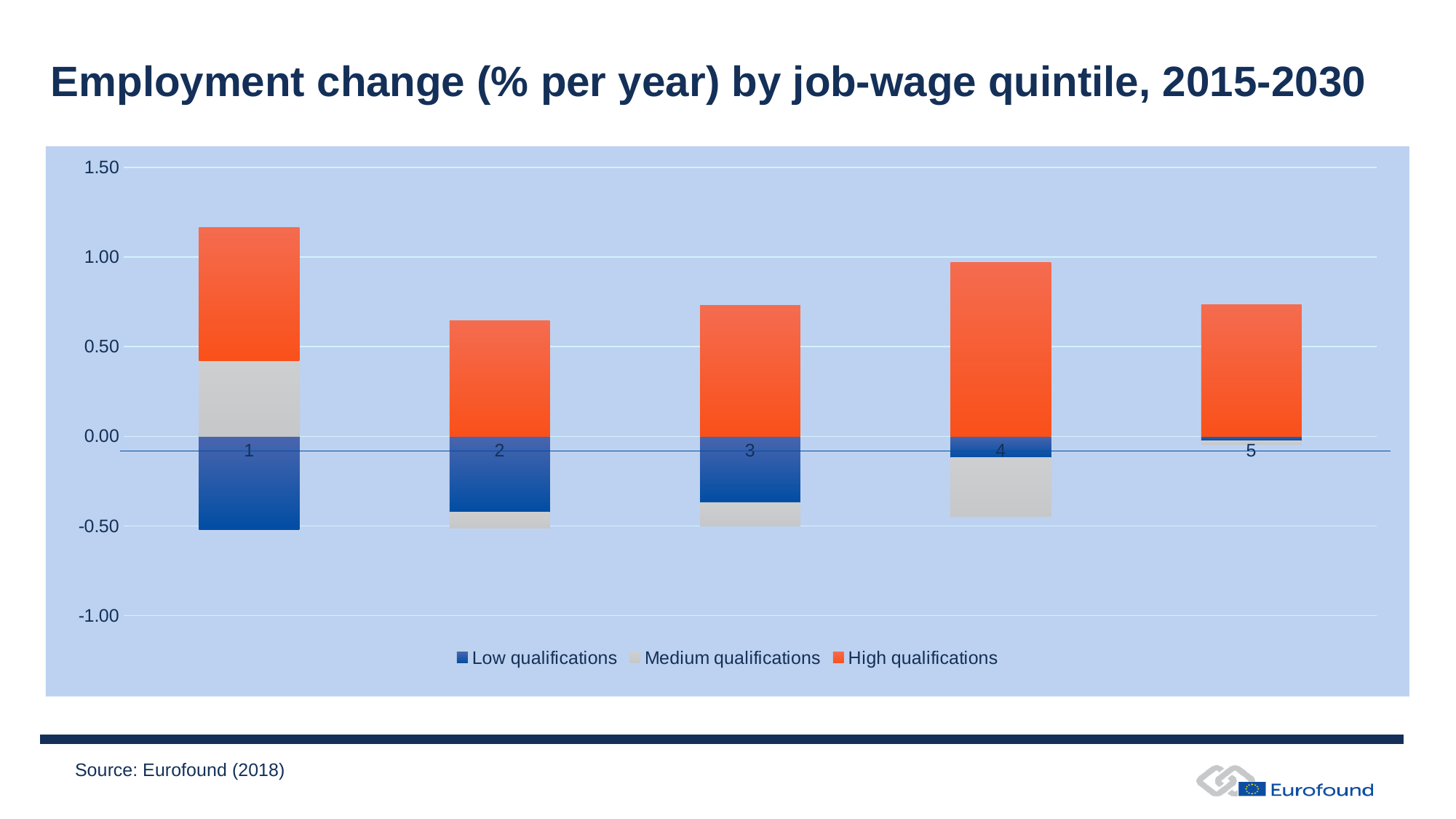
Which series is shown in orange in the legend? High qualifications Which quintile is the only one with a positive Medium qualifications value? 1 Which quintile has a larger High qualifications value, quintile 1 or quintile 4? 4 Which quintile has the smallest negative Low qualifications value (closest to zero)? 5 How many series does the legend list? 3 Is the High qualifications value for quintile 2 greater or less than 0.50? greater Is the Low qualifications value for quintile 3 greater or less than -0.50? greater Which quintile has the largest positive value for High qualifications? 4 What kind of chart is shown on the slide? Stacked bar chart Which quintile has the most negative value for Low qualifications? 1 How many job-wage quintiles are shown on the x axis? 5 Is the High qualifications value for quintile 1 greater or less than 1.00? less